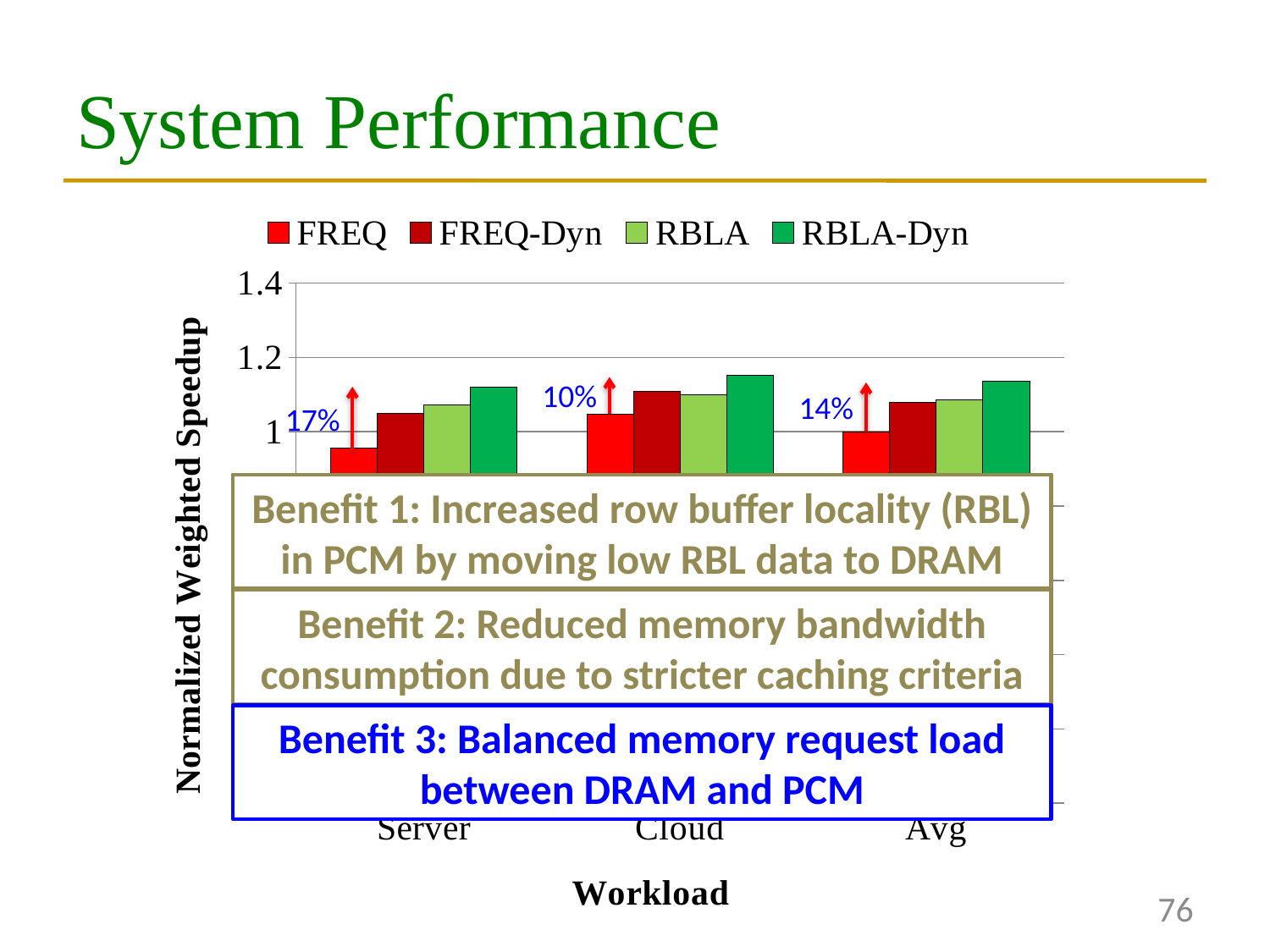
How many workload categories are shown on the x axis? 3 Which series has the highest bar for the Cloud workload? RBLA-Dyn Which is larger for the Server workload, the FREQ bar or the RBLA-Dyn bar? RBLA-Dyn What is the title of the y axis? Normalized Weighted Speedup Which series has the lowest bar for the Avg workload? FREQ How many series does the legend list? 4 Is the value for FREQ in the Server workload greater or less than 1? less Is the value for RBLA-Dyn in the Cloud workload greater or less than 1.2? less Which series has the highest bar for the Server workload? RBLA-Dyn Which series has the lowest bar for the Server workload? FREQ What percentage improvement is annotated above the Server workload group? 17% What kind of chart is shown on the slide? bar chart